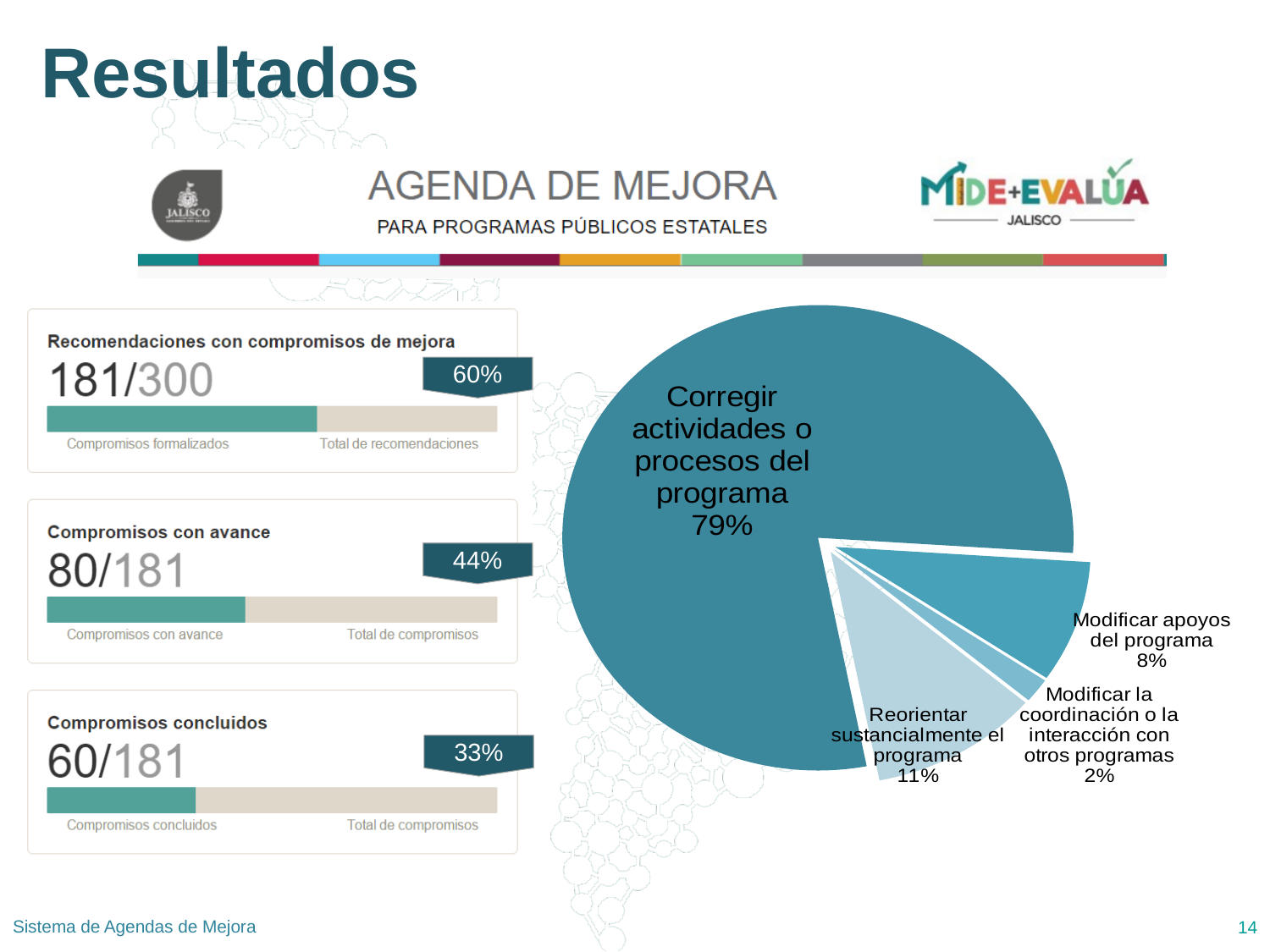
What kind of chart is shown on the right side of the slide? pie chart In the pie chart, what is the difference in percentage points between "Reorientar sustancialmente el programa" and "Modificar apoyos del programa"? 3 percentage points In the pie chart, what share is labelled for "Reorientar sustancialmente el programa"? 11% In the pie chart, what share is labelled for "Modificar apoyos del programa"? 8% In the pie chart, which is larger: the slice for "Modificar apoyos del programa" or the slice for "Reorientar sustancialmente el programa"? Reorientar sustancialmente el programa In the "Recomendaciones con compromisos de mejora" bar on the left, what percentage is shown? 60% How many slices does the pie chart have? 4 In the pie chart, what share is labelled for "Modificar la coordinación o la interacción con otros programas"? 2% In the pie chart, which category has the largest slice? Corregir actividades o procesos del programa In the "Compromisos concluidos" bar on the left, what value is shown as compromisos concluidos out of total de compromisos? 60/181 In the pie chart, which category has the smallest slice? Modificar la coordinación o la interacción con otros programas